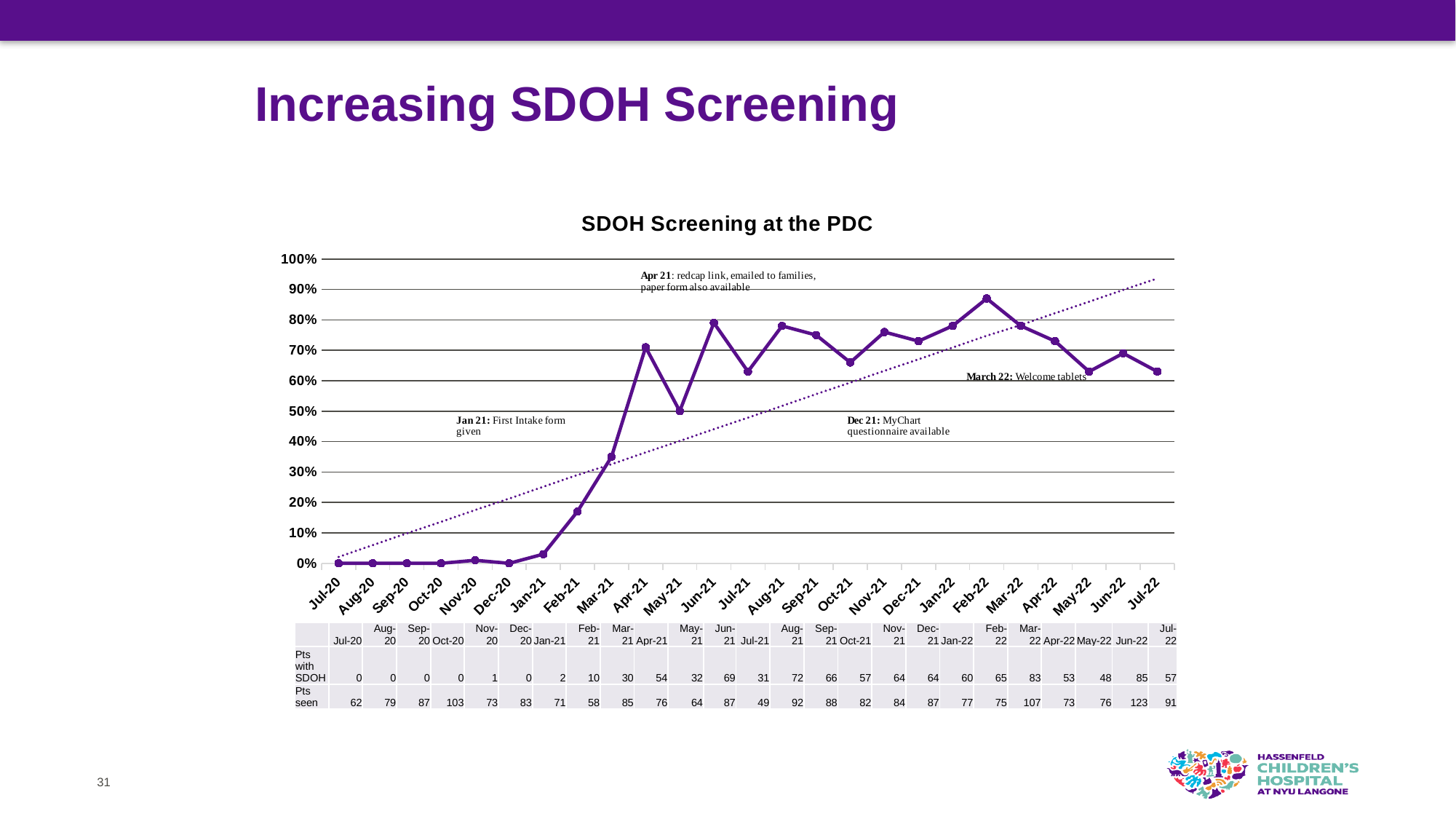
In the data table, which month has the highest number of 'Pts with SDOH'? Jun-22 How many monthly data points are plotted on the 'SDOH Screening at the PDC' chart? 25 In the data table, what is the difference between 'Pts seen' and 'Pts with SDOH' in Jul-22? 34 What kind of chart is 'SDOH Screening at the PDC'? line chart In which month does the plotted SDOH screening percentage reach its highest point? Feb-22 According to the data table, how many 'Pts seen' were there in Jun-22? 123 According to the data table, how many 'Pts with SDOH' were there in Mar-22? 83 Is the plotted screening value for Jul-22 greater or less than 70%? less Is the plotted screening value for Jun-21 greater or less than 70%? greater Is the plotted screening value for Feb-22 greater or less than 80%? greater Overall, does the plotted SDOH screening percentage rise or fall from Jul-20 to Jul-22? rise